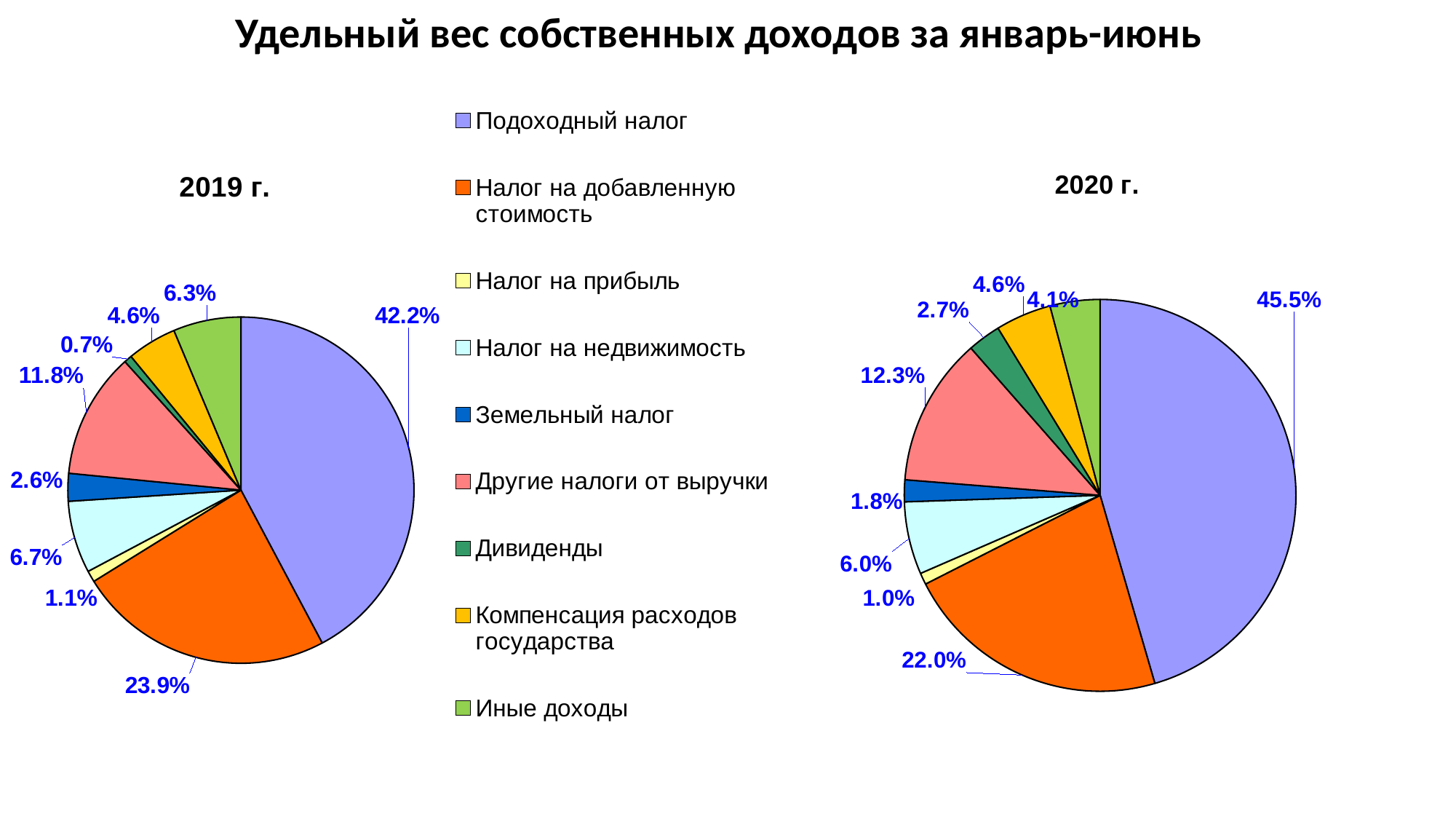
What is the difference between the share of Подоходный налог in the 2020 г. chart and in the 2019 г. chart? 3.3% What type of chart is used for the 2019 г. chart? pie chart In the 2019 г. chart, what share does Подоходный налог have? 42.2% In the 2020 г. chart, what share does Налог на добавленную стоимость have? 22.0% In the 2019 г. chart, which category has the smallest share? Дивиденды In the 2020 г. chart, which is larger: Другие налоги от выручки or Налог на недвижимость? Другие налоги от выручки How many categories does the legend list? 9 In the 2020 г. chart, what share does Дивиденды have? 2.7% In the 2020 г. chart, which category has the largest share? Подоходный налог What is the title of the slide? Удельный вес собственных доходов за январь-июнь In the 2019 г. chart, what is the combined share of Подоходный налог and Налог на добавленную стоимость? 66.1% In the 2019 г. chart, which is larger: Налог на недвижимость or Иные доходы? Налог на недвижимость